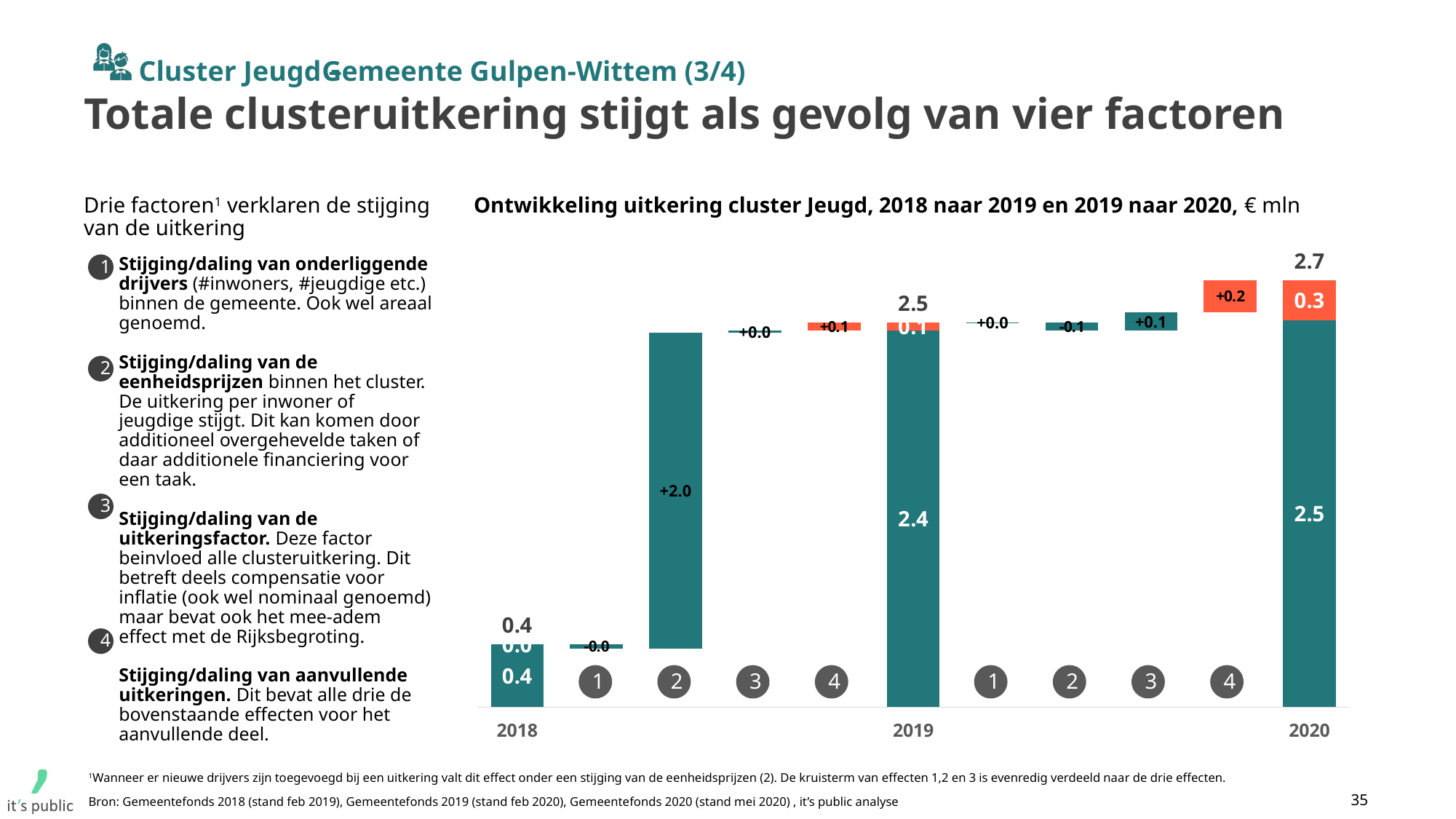
What is the value of the factor 4 step between 2019 and 2020? +0.2 Which year has the highest total uitkering? 2020 What kind of chart is shown on the slide? bar chart What is the value of the teal (bottom) segment of the 2019 bar? 2.4 What is the total uitkering for 2019 shown in the chart? 2.5 By how much does the total uitkering increase from 2019 to 2020? 0.2 What is the value of the orange (top) segment of the 2020 bar? 0.3 What is the value of the factor 2 step between 2018 and 2019? +2.0 What is the total uitkering for 2020 shown in the chart? 2.7 Do the year totals rise or fall from 2018 to 2020? rise What is the total uitkering for 2018 shown in the chart? 0.4 Which year has the lowest total uitkering? 2018